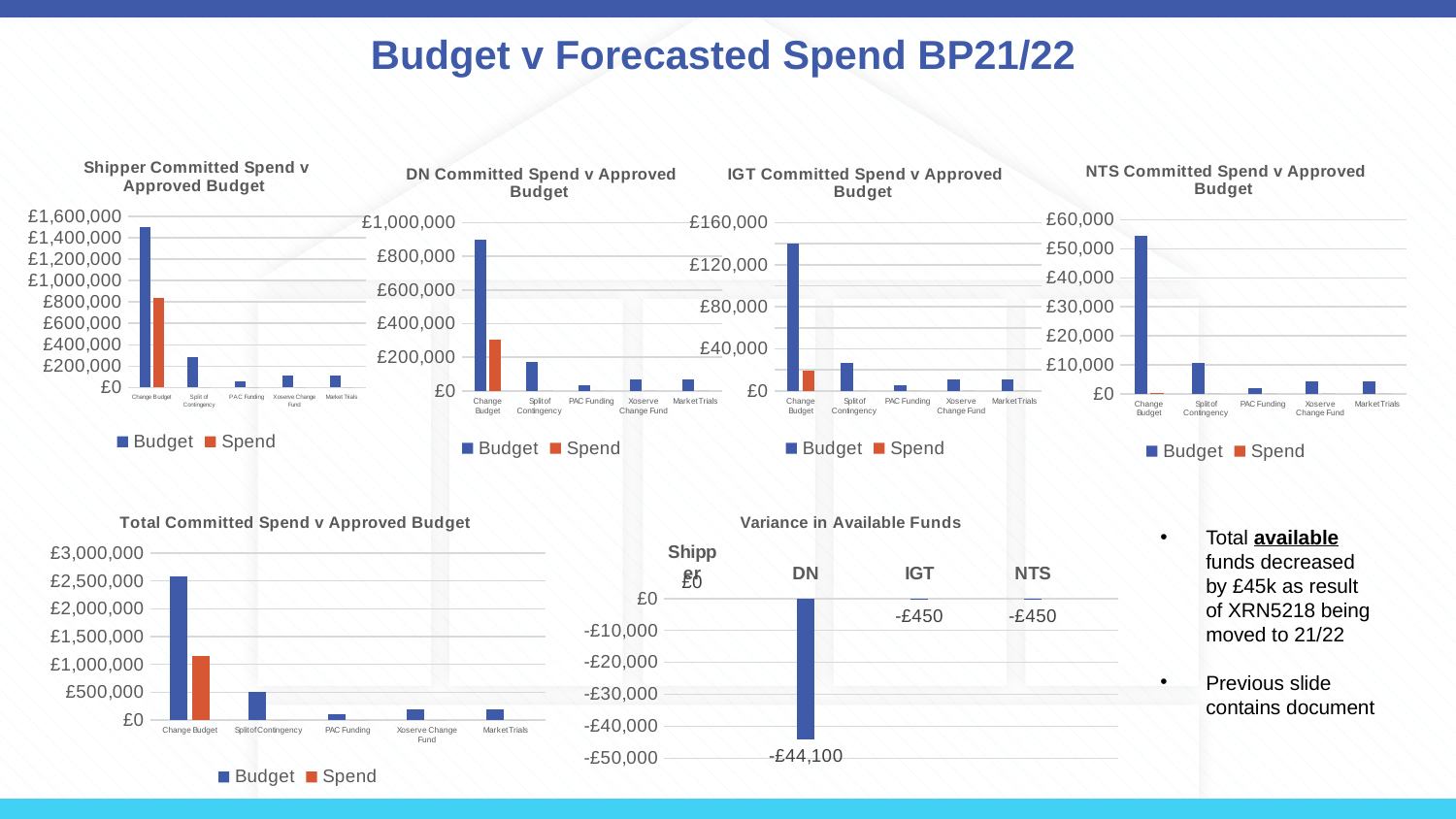
How many categories are shown in the Variance in Available Funds chart? 4 In the Variance in Available Funds chart, what is the value for IGT? -£450 In the Variance in Available Funds chart, which category has the lowest value? DN In the IGT Committed Spend v Approved Budget chart, which category has the highest Budget value? Change Budget In the Shipper Committed Spend v Approved Budget chart, which is larger for Change Budget, Budget or Spend? Budget In the Variance in Available Funds chart, what is the value for Shipper? £0 In the Variance in Available Funds chart, what is the value for DN? -£44,100 In the DN Committed Spend v Approved Budget chart, is the Spend value for Change Budget greater or less than £400,000? less How many series does the legend list in the Shipper Committed Spend v Approved Budget chart? 2 In the Total Committed Spend v Approved Budget chart, is the Budget value for Change Budget greater or less than £2,000,000? greater In the Shipper Committed Spend v Approved Budget chart, is the Budget value for Change Budget greater or less than £1,400,000? greater What kind of chart is the Total Committed Spend v Approved Budget chart? Bar chart